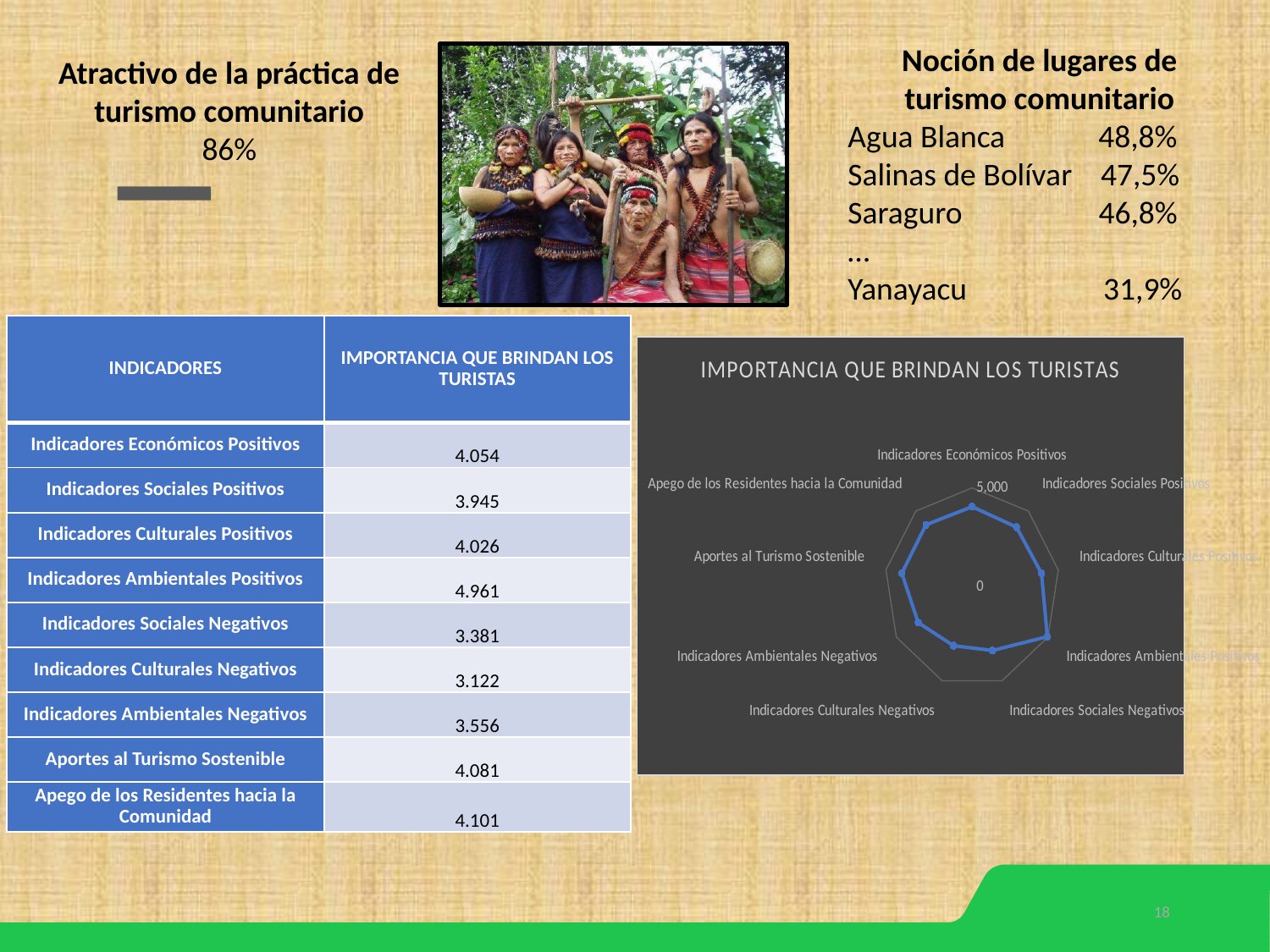
Which category has the lowest value in the chart? Indicadores Culturales Negativos What is the maximum value shown on the radar chart's axis scale? 5,000 Which is larger, the value for Aportes al Turismo Sostenible or the value for Indicadores Sociales Negativos? Aportes al Turismo Sostenible What is the value for Indicadores Culturales Negativos? 3.122 What is the difference between the values for Indicadores Ambientales Positivos and Indicadores Culturales Negativos? 1.839 Is the value for Indicadores Culturales Negativos greater or less than 5,000? less What is the value for Indicadores Ambientales Positivos? 4.961 How many categories (axes) does the radar chart have? 9 Which category has the highest value in the chart? Indicadores Ambientales Positivos What is the value for Apego de los Residentes hacia la Comunidad? 4.101 What is the title of the chart on the slide? IMPORTANCIA QUE BRINDAN LOS TURISTAS What kind of chart is shown on the slide? Radar chart